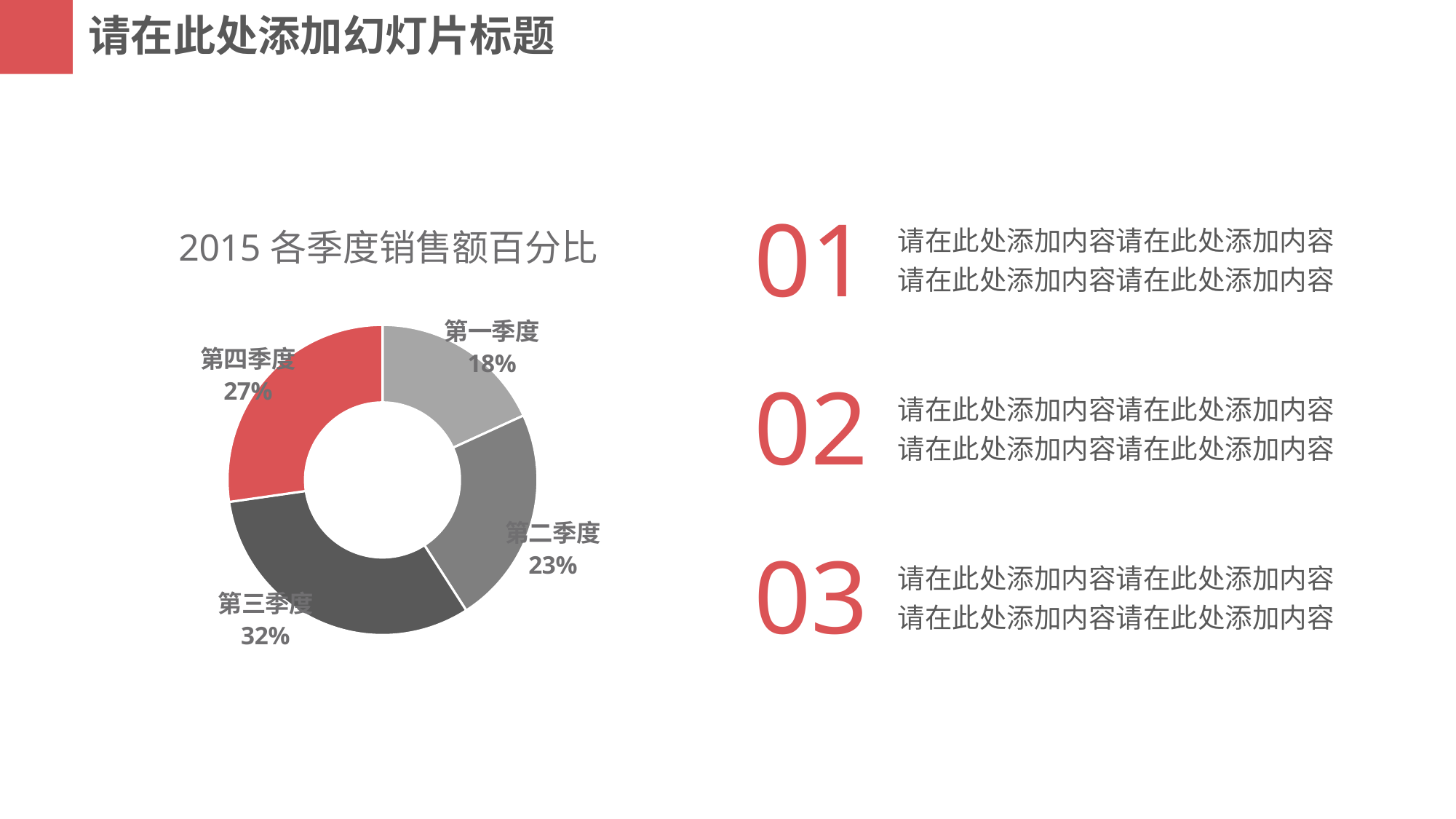
Which quarter's slice is coloured red? 第四季度 What is the value for 第二季度? 23% Which quarter has the smallest share? 第一季度 What is the title of the chart? 2015 各季度销售额百分比 What kind of chart is shown on the slide? Doughnut chart What is the value for 第三季度? 32% What is the value for 第一季度? 18% Which is larger, the share of 第四季度 or 第二季度? 第四季度 What is the value for 第四季度? 27% How many categories does the chart show? 4 Which quarter has the largest share? 第三季度 What is the difference between the shares of 第三季度 and 第一季度? 14%